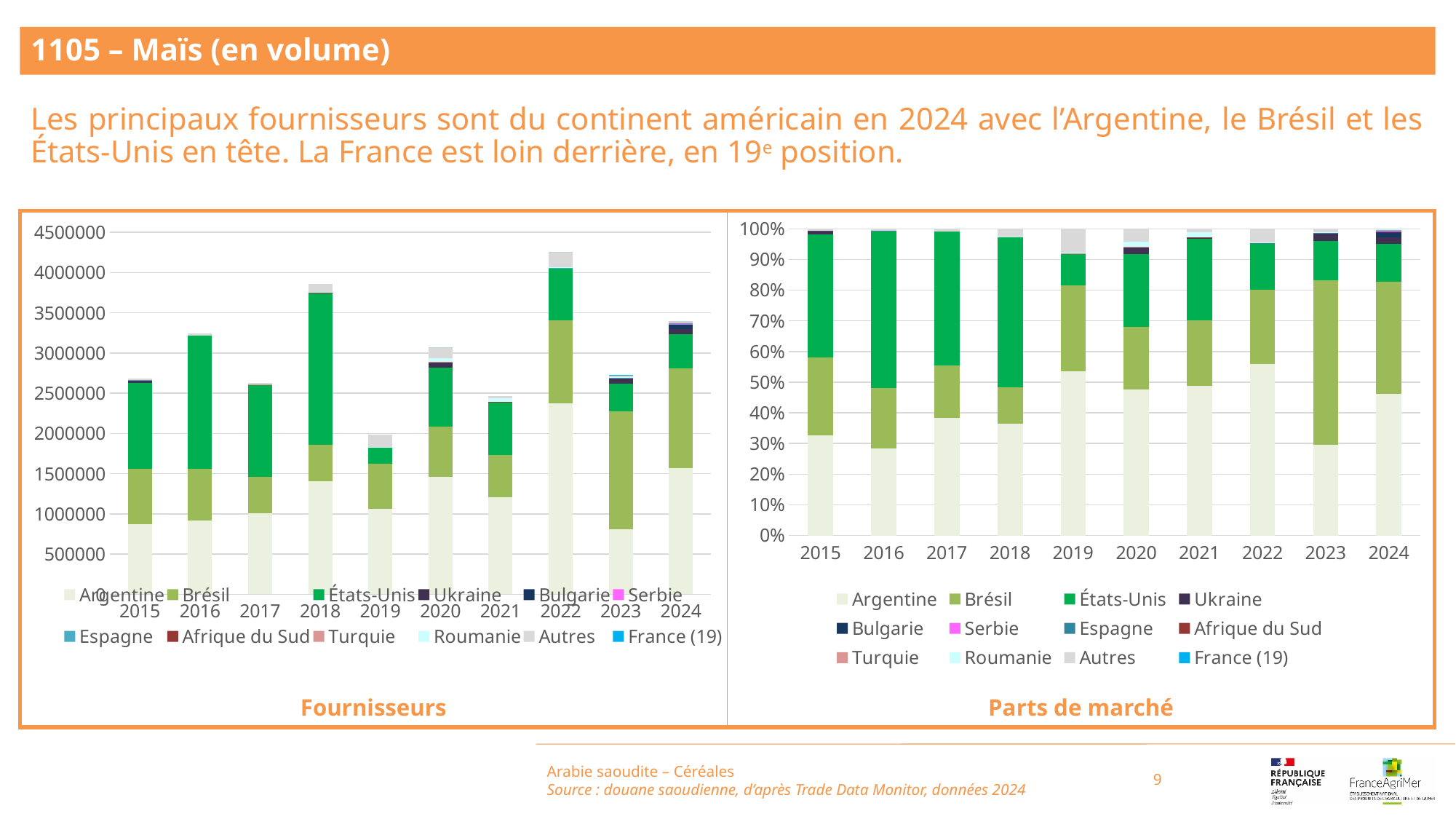
In the 'Parts de marché' chart, is the share of Argentine in 2022 greater or less than 50%? greater In the 'Fournisseurs' chart, is the total for 2022 greater or less than 4000000? greater In the 'Parts de marché' chart, is the share of Argentine larger in 2019 or in 2016? 2019 In the 'Fournisseurs' chart, is the total for 2024 greater or less than 3000000? greater Which series is listed first in the legend of the 'Fournisseurs' chart? Argentine How many series does the legend of the 'Parts de marché' chart list? 12 In the 'Fournisseurs' chart, which year has the lowest total bar? 2019 In the 'Fournisseurs' chart, which year has the highest total bar? 2022 What kind of chart is the 'Fournisseurs' chart on the left? bar chart How many years are shown on the x axis of the 'Fournisseurs' chart? 10